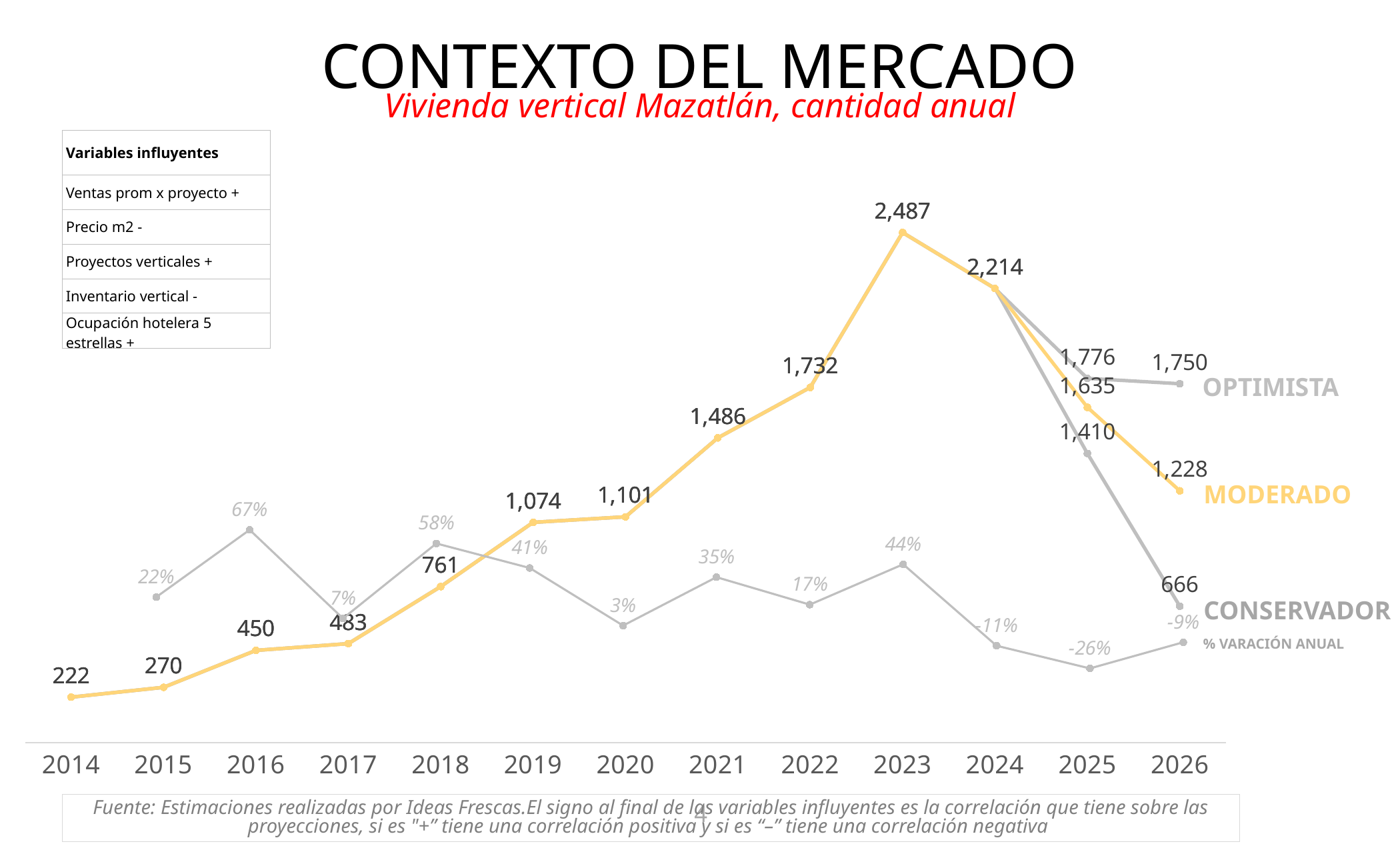
What kind of chart is this? line chart Which year has the highest value on the main line? 2023 What is the 2025 value for the MODERADO scenario? 1,635 What is the % VARIACIÓN ANUAL shown for 2016? 67% How many years are shown on the x axis? 13 What is the difference between the 2023 value and the 2024 value? 273 Which is larger, the value for 2019 or the value for 2020? 2020 What is the % VARIACIÓN ANUAL shown for 2025? -26% What is the value shown for 2014? 222 What is the 2026 value for the CONSERVADOR scenario? 666 What is the value shown for 2023? 2,487 What is the 2026 value for the OPTIMISTA scenario? 1,750